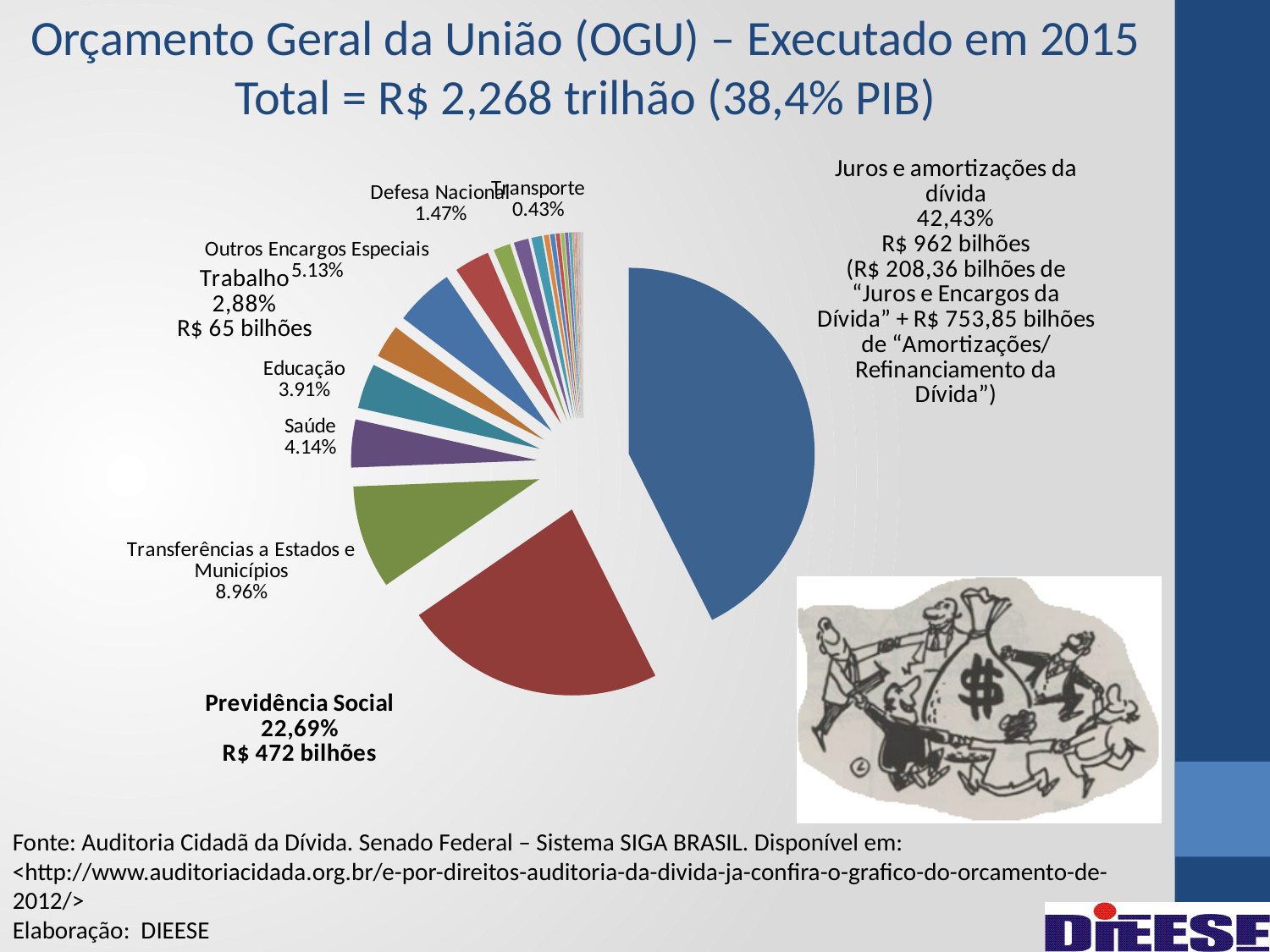
According to the slide title, what is the total of the executed budget in 2015? R$ 2,268 trilhão What share of the budget goes to "Juros e amortizações da dívida"? 42,43% What kind of chart is shown on the slide? pie chart What is the difference in percentage points between "Saúde" and "Educação"? 0.23% What is the value in reais shown for "Previdência Social"? R$ 472 bilhões What is the value in reais shown for "Trabalho"? R$ 65 bilhões What percentage is shown for "Saúde"? 4.14% What is the difference in percentage points between "Juros e amortizações da dívida" and "Previdência Social"? 19,74% Among the labelled slices, which category has the smallest share? Transporte What percentage is shown for "Transferências a Estados e Municípios"? 8.96% Which has a larger share, "Outros Encargos Especiais" or "Educação"? Outros Encargos Especiais Which category has the largest slice of the pie? Juros e amortizações da dívida